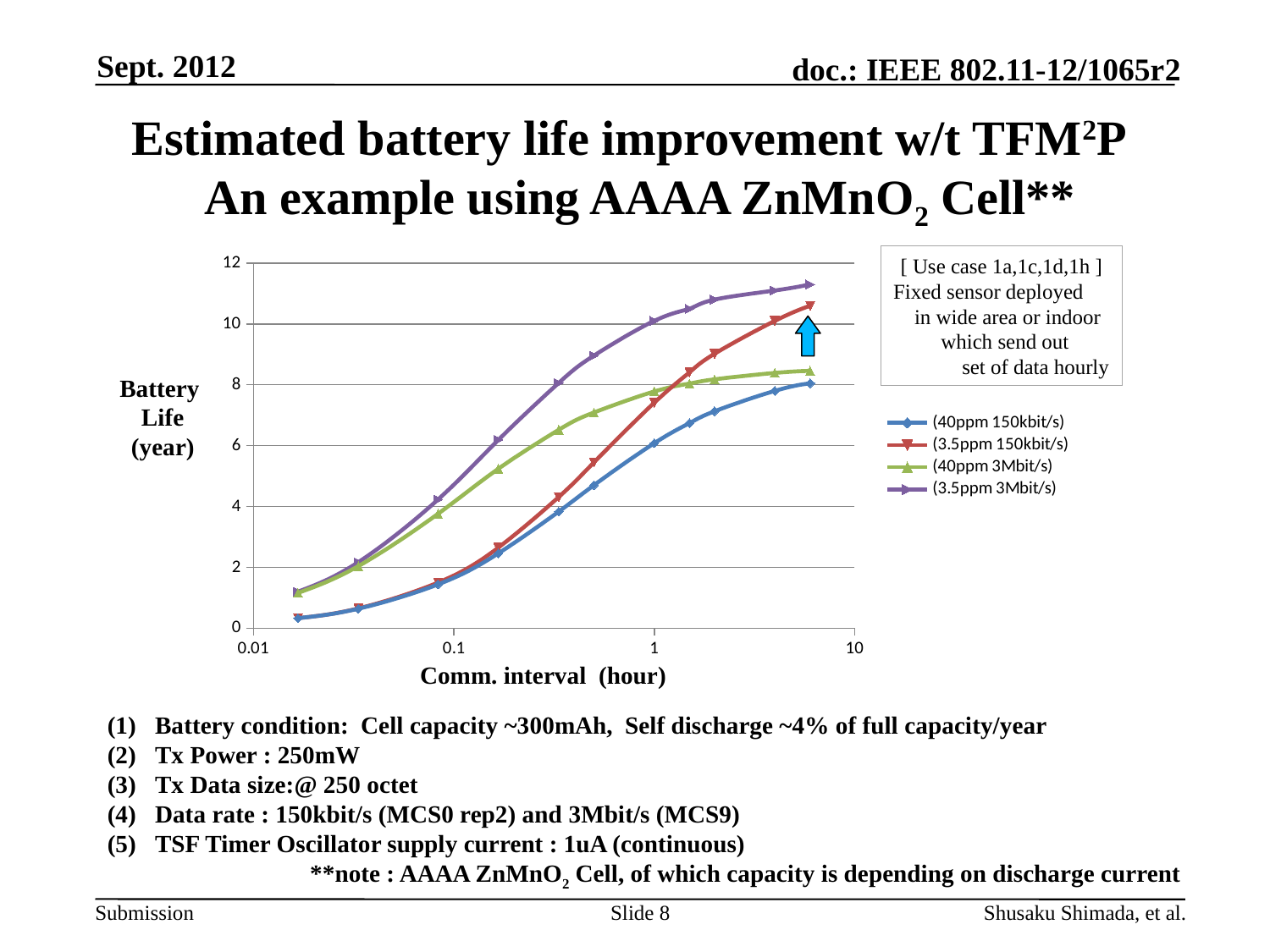
At a communication interval of 0.1 hour, is the battery life for (40ppm 150kbit/s) greater or less than 2? less Do the battery life values rise or fall as the communication interval increases? rise At a communication interval of 1 hour, is the battery life for (40ppm 150kbit/s) greater or less than 8? less What is the label of the x axis of the chart? Comm. interval (hour) How many series does the chart legend list? 4 Which series reaches the highest battery life on the chart? (3.5ppm 3Mbit/s) At the rightmost point of the chart, is the battery life for (3.5ppm 3Mbit/s) greater or less than 10? greater What kind of chart is shown on the slide? line chart What is the label of the y axis of the chart? Battery Life (year) At a communication interval of 0.1 hour, which series has the higher battery life, (40ppm 3Mbit/s) or (40ppm 150kbit/s)? (40ppm 3Mbit/s) At a communication interval of 1 hour, which series has the higher battery life, (3.5ppm 3Mbit/s) or (40ppm 150kbit/s)? (3.5ppm 3Mbit/s)